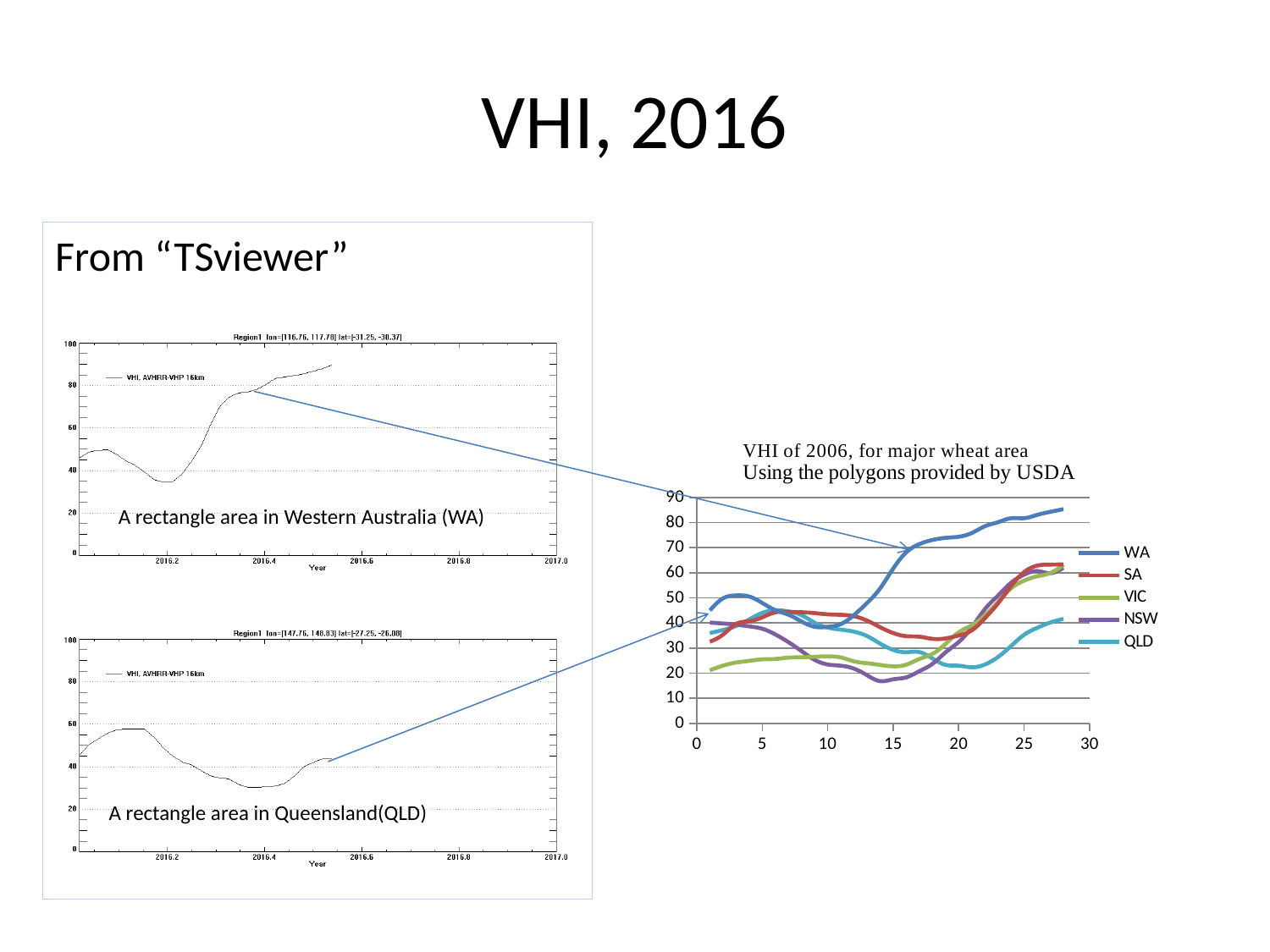
On the top-left chart (A rectangle area in Western Australia (WA)), is the value at 2016.2 greater or less than 40? less What kind of chart is the right-hand chart (VHI of 2006, for major wheat area)? Line chart On the right-hand chart (VHI of 2006, for major wheat area), which series has the highest value at the right end of the x axis (around 28)? WA On the bottom-left chart (A rectangle area in Queensland(QLD)), what is the x-axis label? Year On the right-hand chart (VHI of 2006, for major wheat area), is the value for WA at x = 28 greater or less than 80? greater On the right-hand chart (VHI of 2006, for major wheat area), how many series does the legend list? 5 On the right-hand chart (VHI of 2006, for major wheat area), is the value for QLD at x = 20 greater or less than 30? less On the right-hand chart (VHI of 2006, for major wheat area), which is larger at x = 28, WA or QLD? WA On the right-hand chart (VHI of 2006, for major wheat area), which series is drawn in red according to the legend? SA On the right-hand chart (VHI of 2006, for major wheat area), which series has the lowest value around x = 14? NSW On the right-hand chart (VHI of 2006, for major wheat area), does the WA series rise or fall between x = 15 and x = 28? rise